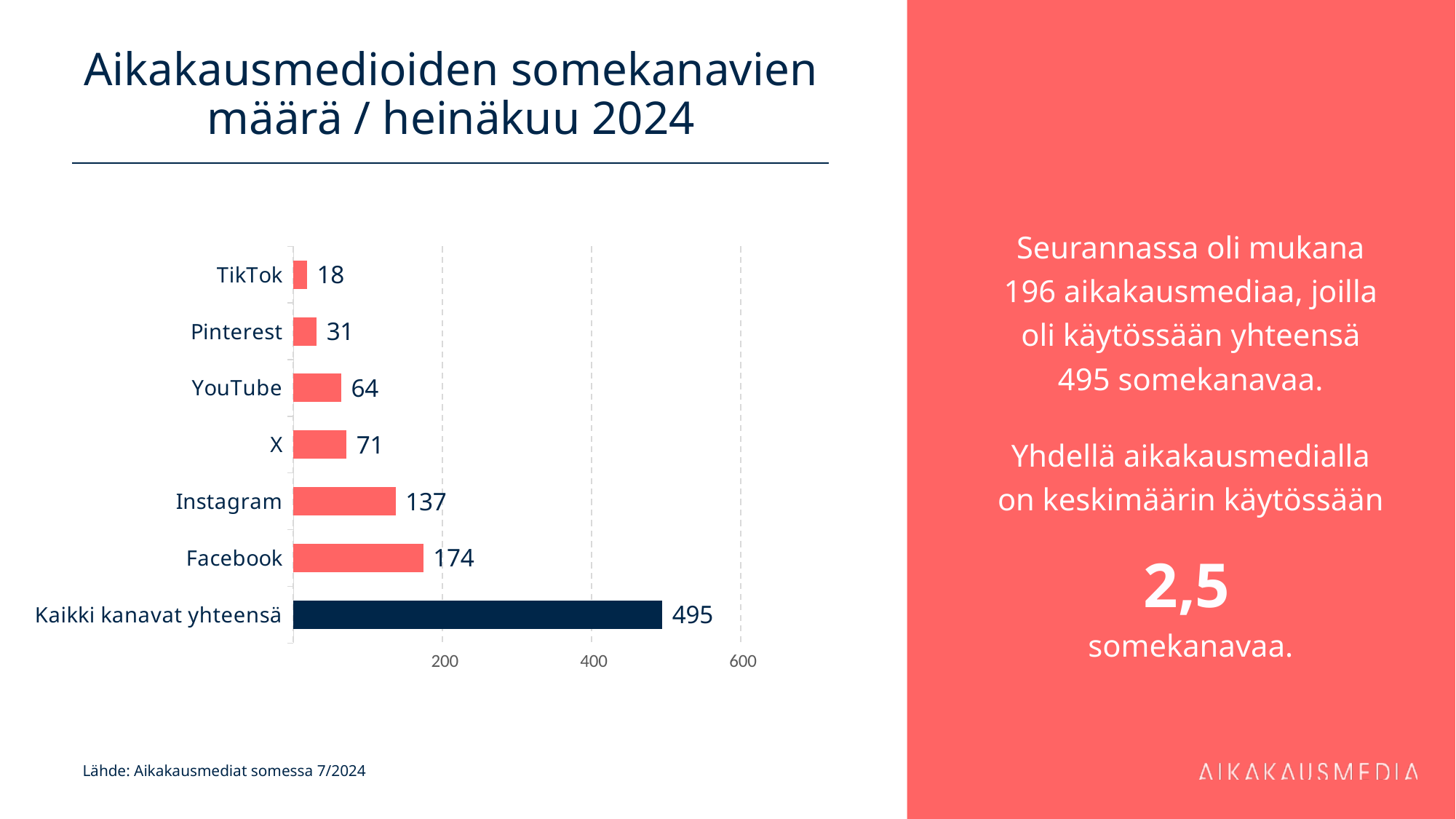
Which individual channel (excluding the total bar) has the highest value? Facebook What is the value for TikTok? 18 Which category has the lowest value? TikTok What is the value for Facebook? 174 How many categories are shown on the chart? 7 Is the value for Kaikki kanavat yhteensä greater or less than 400? greater What is the difference between the values for X and YouTube? 7 What is the value for Kaikki kanavat yhteensä? 495 What is the value for Instagram? 137 What is the difference between the values for Facebook and Instagram? 37 What kind of chart is shown on the slide? Bar chart Which is larger, the value for Pinterest or the value for YouTube? YouTube